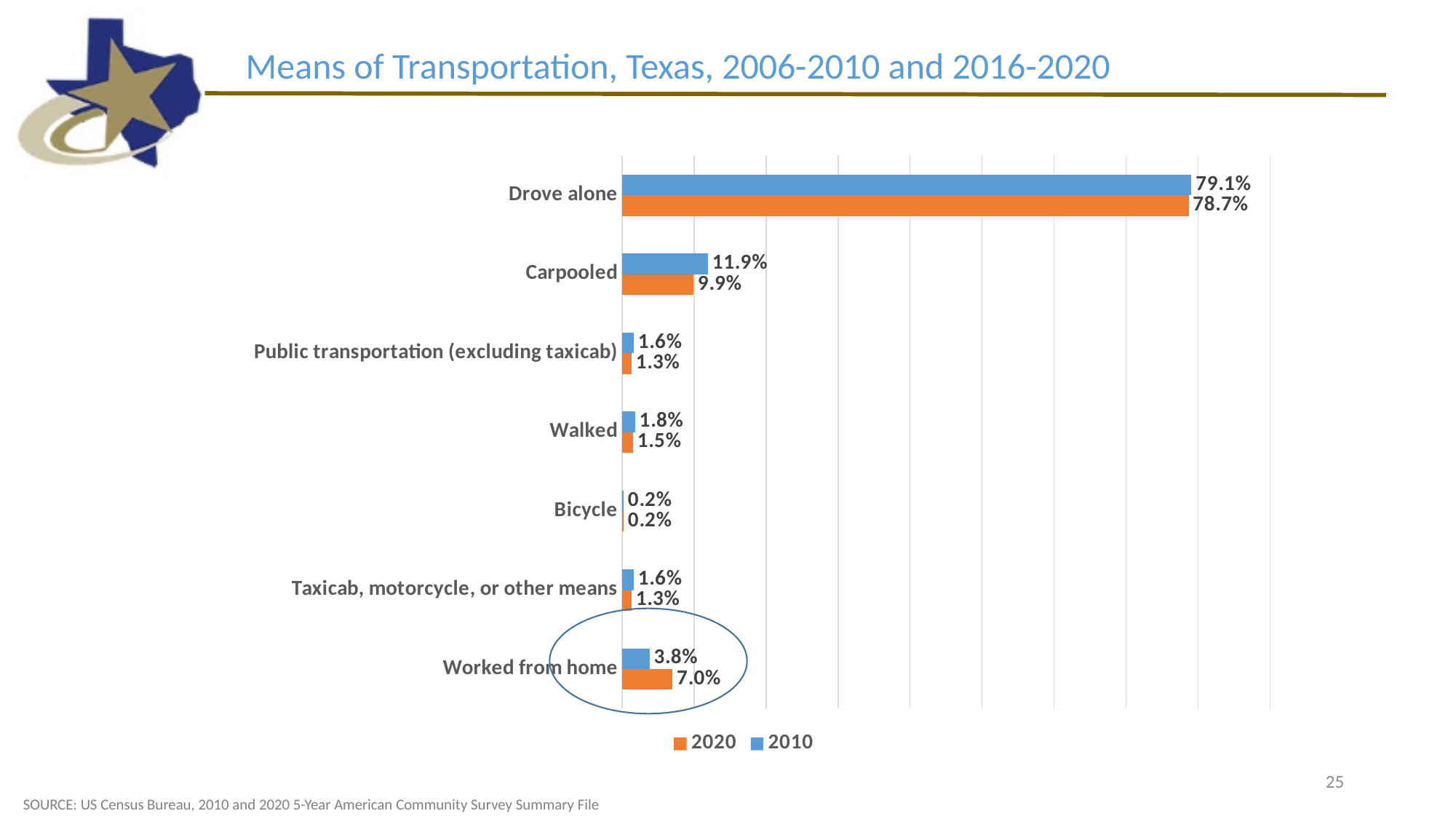
What is the difference between the 2010 and 2020 values for Drove alone? 0.4% What is the difference between the 2020 and 2010 values for Worked from home? 3.2% Which series is shown in orange in the chart? 2020 How many means of transportation categories are shown in the chart? 7 Which is larger for Carpooled, the 2010 value or the 2020 value? 2010 How many series does the legend list? 2 Which category has the lowest 2020 value? Bicycle Which category has the highest 2010 value? Drove alone What is the 2020 value for Worked from home? 7.0% What is the 2020 value for Drove alone? 78.7% What kind of chart is shown on the slide? Bar chart What is the 2010 value for Carpooled? 11.9%